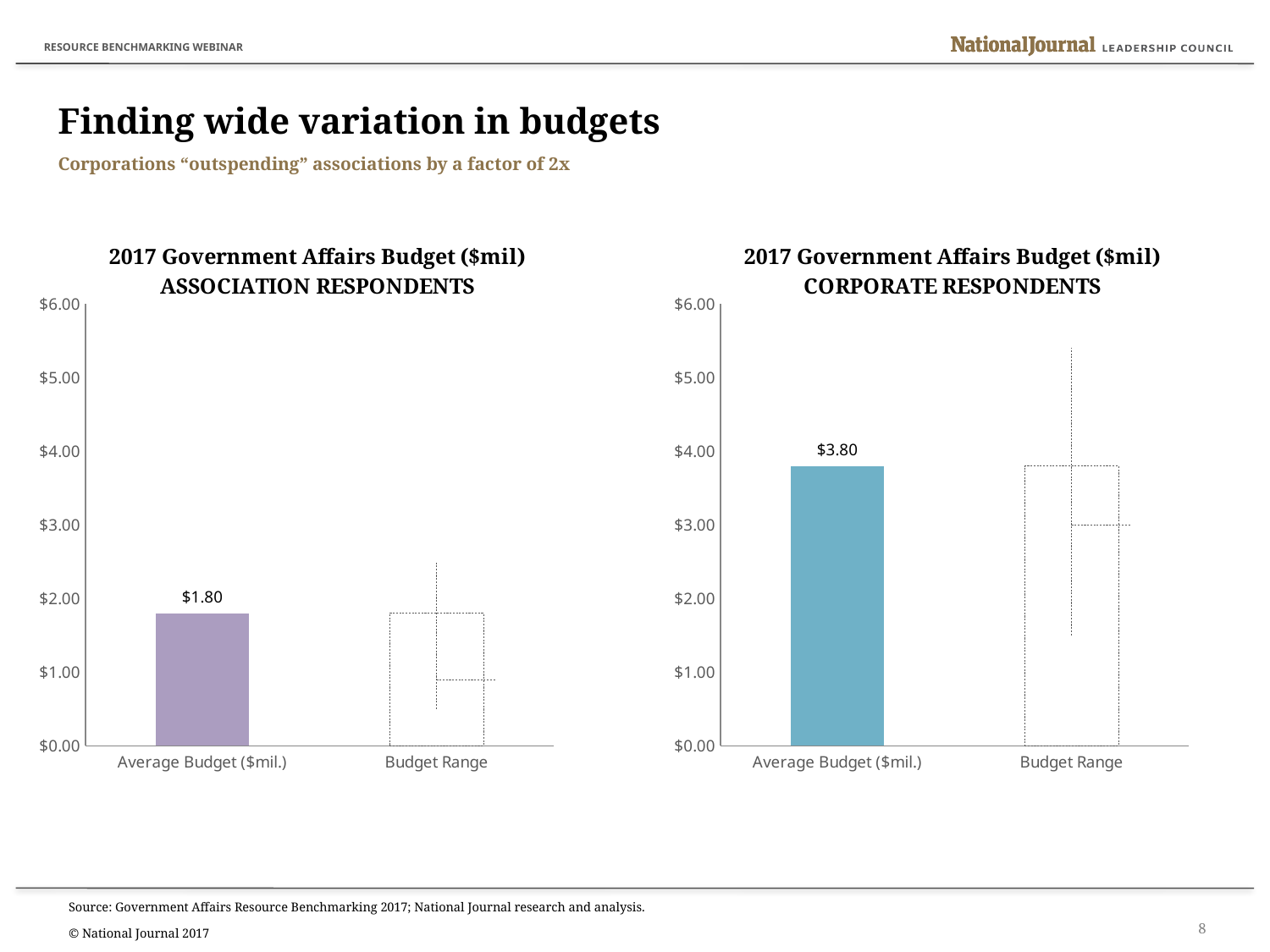
In the CORPORATE RESPONDENTS chart, does the top of the Budget Range whisker extend above or below $5.00? above In the CORPORATE RESPONDENTS chart, is the Average Budget ($mil.) bar greater or less than $3.00? greater In the ASSOCIATION RESPONDENTS chart, does the top of the Budget Range whisker extend above or below $3.00? below What is the difference between the average budget in the CORPORATE RESPONDENTS chart and the average budget in the ASSOCIATION RESPONDENTS chart? $2.00 What is the maximum value shown on the y axis of the ASSOCIATION RESPONDENTS chart? $6.00 In the CORPORATE RESPONDENTS chart, what is the value of the Average Budget ($mil.) bar? $3.80 How many categories are shown on the x axis of the ASSOCIATION RESPONDENTS chart? 2 What is the title of the chart on the right side of the slide? 2017 Government Affairs Budget ($mil) CORPORATE RESPONDENTS Which is larger: the average budget in the CORPORATE RESPONDENTS chart or the average budget in the ASSOCIATION RESPONDENTS chart? CORPORATE RESPONDENTS What kind of chart is the CORPORATE RESPONDENTS chart? bar chart In the ASSOCIATION RESPONDENTS chart, what is the value of the Average Budget ($mil.) bar? $1.80